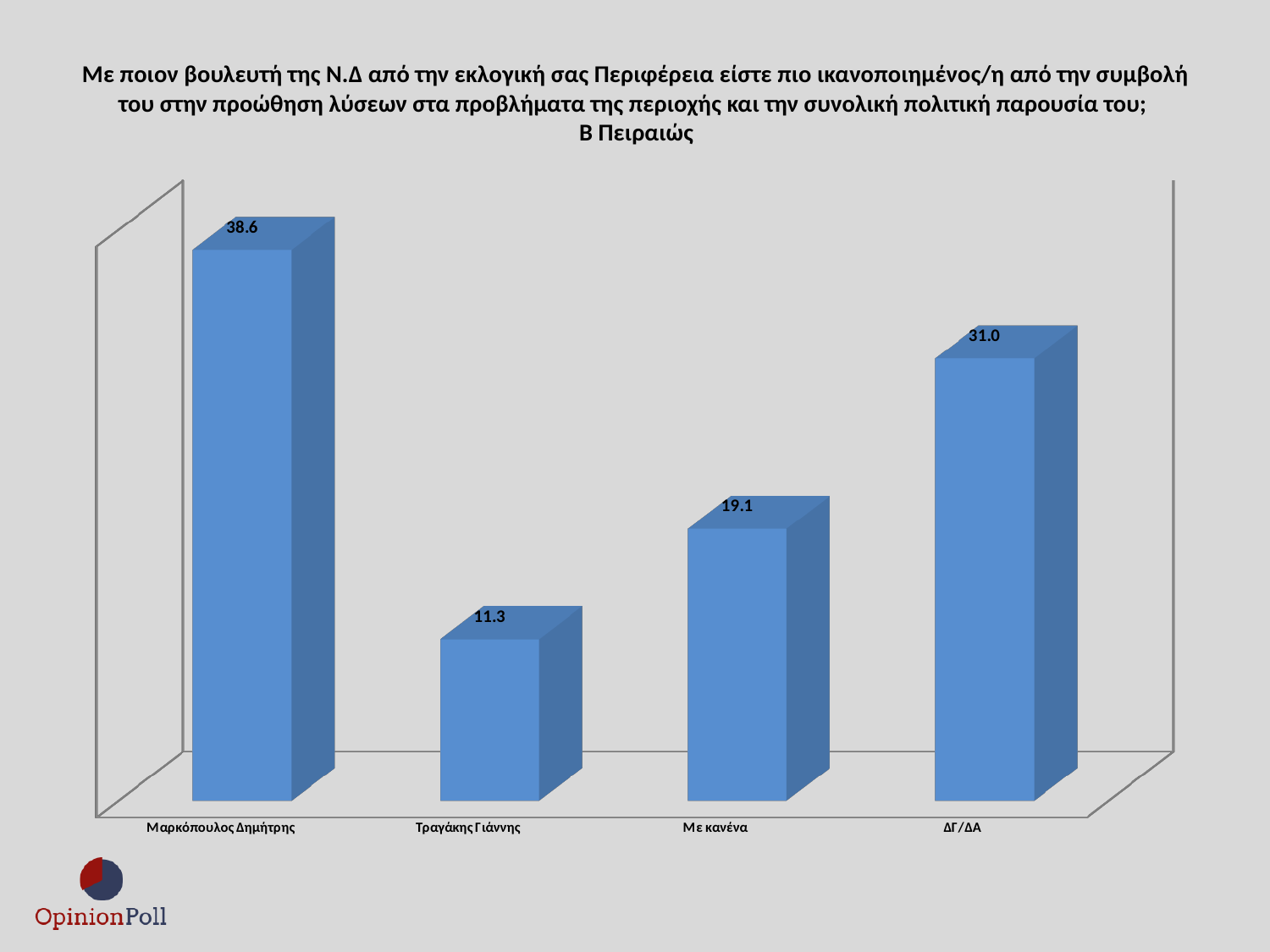
How many categories are shown on the chart? 4 What is the value for Με κανένα? 19.1 What is the value for ΔΓ/ΔΑ? 31.0 What is the difference between the values for Με κανένα and Τραγάκης Γιάννης? 7.8 What is the value for Μαρκόπουλος Δημήτρης? 38.6 Which category has the lowest value? Τραγάκης Γιάννης What kind of chart is shown on the slide? Bar chart Which is larger, the value for Με κανένα or the value for ΔΓ/ΔΑ? ΔΓ/ΔΑ What is the value for Τραγάκης Γιάννης? 11.3 Which category has the highest value? Μαρκόπουλος Δημήτρης What is the difference between the values for Μαρκόπουλος Δημήτρης and ΔΓ/ΔΑ? 7.6 Which region is named in the last line of the chart title? Β Πειραιώς